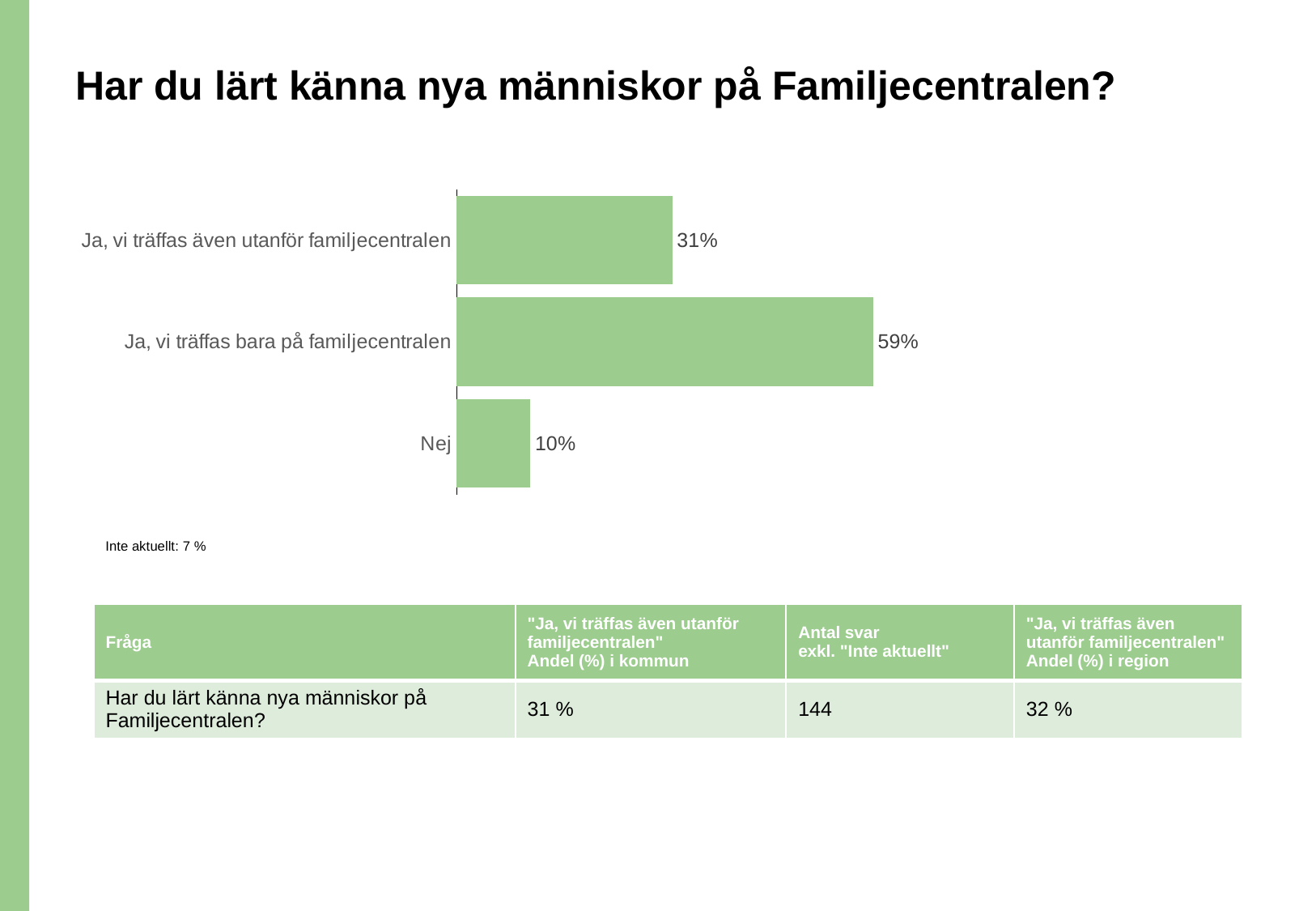
What is the value for "Nej"? 10% How many categories are shown in the chart? 3 What kind of chart is shown on the slide? Bar chart What is the difference between "Ja, vi träffas bara på familjecentralen" and "Ja, vi träffas även utanför familjecentralen"? 28% Which category has the highest value? Ja, vi träffas bara på familjecentralen Which is larger: "Ja, vi träffas även utanför familjecentralen" or "Nej"? Ja, vi träffas även utanför familjecentralen What is the value for "Ja, vi träffas även utanför familjecentralen"? 31% What is the value for "Ja, vi träffas bara på familjecentralen"? 59% Which category has the lowest value? Nej What colour are the bars in the chart? Green What is the difference between "Ja, vi träffas även utanför familjecentralen" and "Nej"? 21% What is the title of the slide? Har du lärt känna nya människor på Familjecentralen?